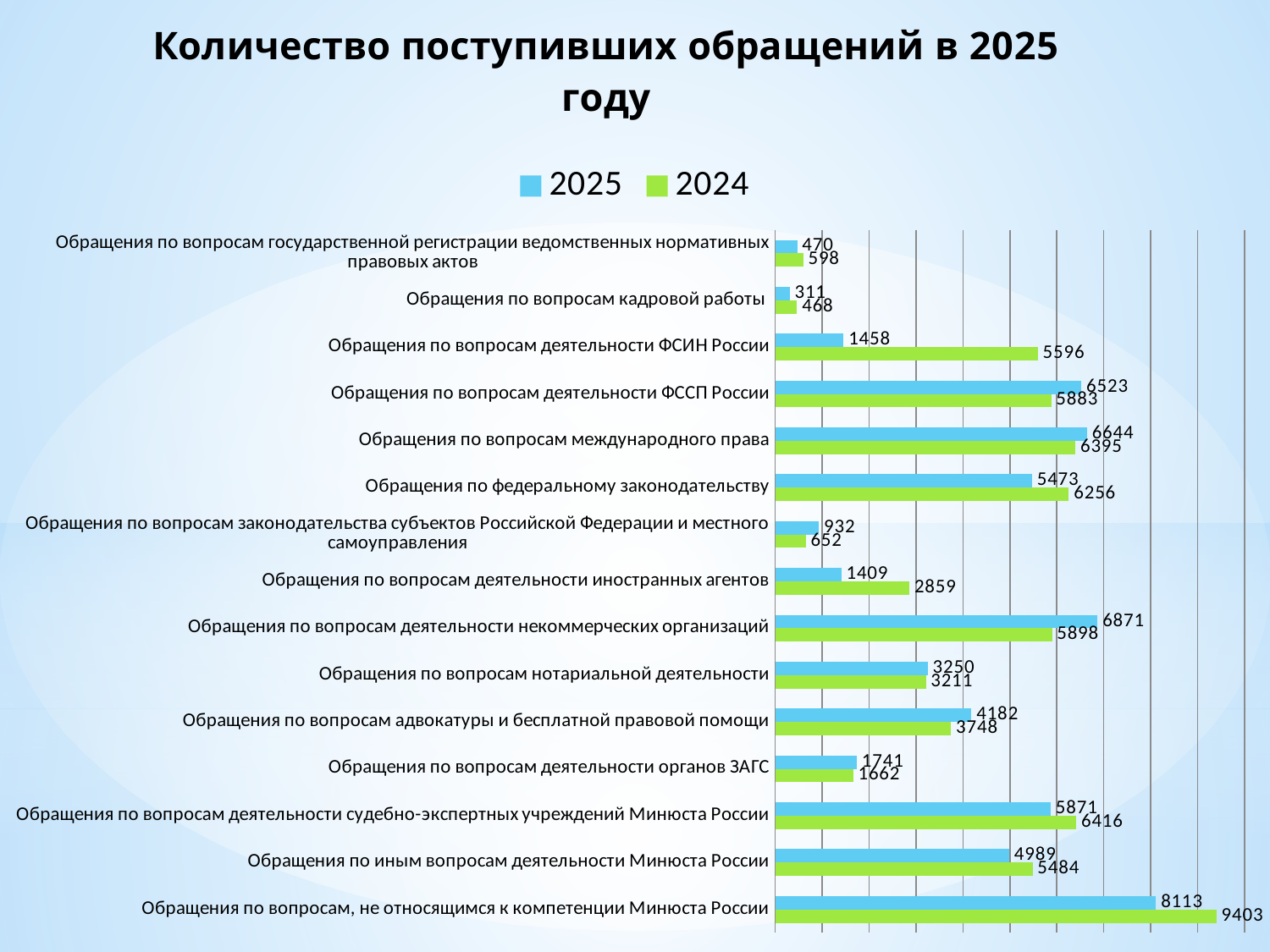
What is the difference between the 2024 and 2025 values for "Обращения по вопросам деятельности ФСИН России"? 4138 Which colour represents the 2024 series in the legend? Green Which category has the lowest 2024 value? Обращения по вопросам кадровой работы How many series does the legend list? 2 How many categories are shown on the chart? 15 What is the 2025 value for "Обращения по вопросам деятельности ФСИН России"? 1458 Which is larger for "Обращения по вопросам деятельности некоммерческих организаций": the 2025 value or the 2024 value? 2025 Which category has the highest 2025 value? Обращения по вопросам, не относящимся к компетенции Минюста России What is the difference between the 2024 and 2025 values for "Обращения по вопросам, не относящимся к компетенции Минюста России"? 1290 What is the 2025 value for "Обращения по вопросам адвокатуры и бесплатной правовой помощи"? 4182 What is the 2024 value for "Обращения по вопросам деятельности иностранных агентов"? 2859 What type of chart is shown on the slide? Bar chart